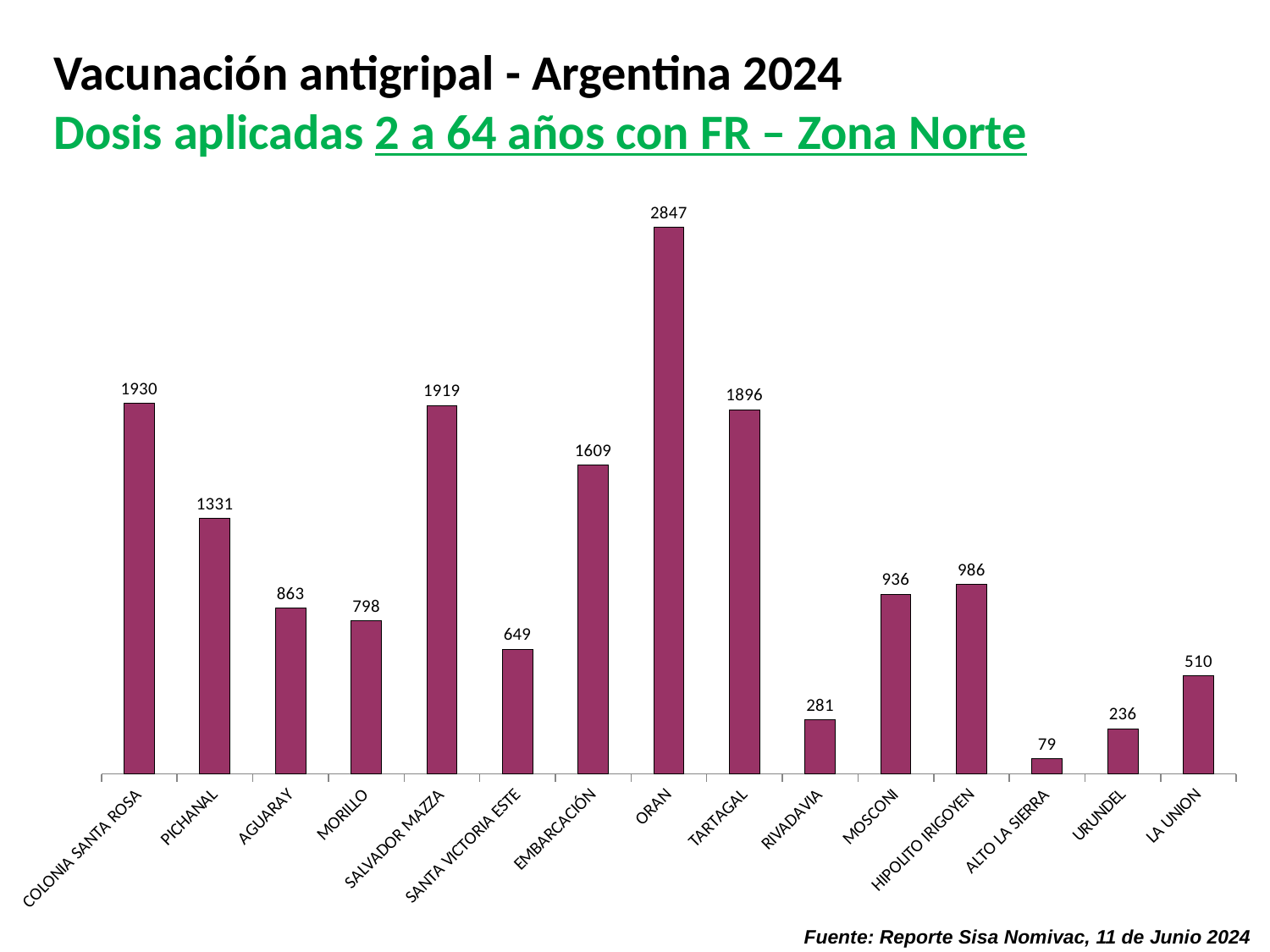
What is the value for ORAN? 2847 Which category has the lowest value? ALTO LA SIERRA What kind of chart is shown on the slide? Bar chart Which is larger, the value for MOSCONI or the value for LA UNION? MOSCONI Which category has the highest value? ORAN What is the difference between the values for ORAN and TARTAGAL? 951 How many categories are shown on the x axis? 15 What source is cited at the bottom of the slide? Reporte Sisa Nomivac, 11 de Junio 2024 Which is larger, the value for AGUARAY or the value for EMBARCACIÓN? EMBARCACIÓN What is the value for SANTA VICTORIA ESTE? 649 What is the value for HIPOLITO IRIGOYEN? 986 What is the difference between the values for COLONIA SANTA ROSA and PICHANAL? 599